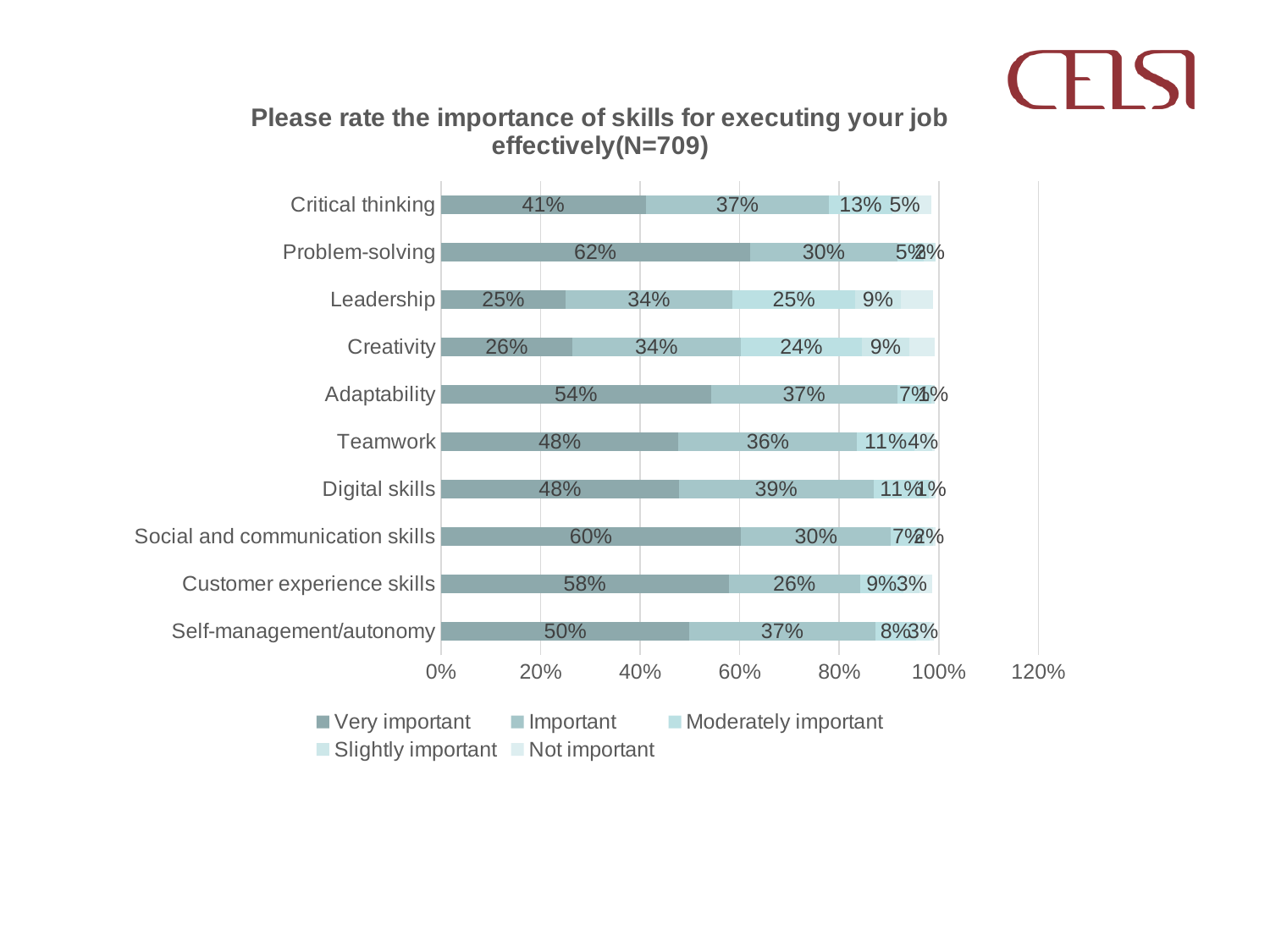
What kind of chart is shown on the slide? Stacked bar chart Which has a larger "Important" share: Teamwork or Digital skills? Digital skills What percentage of respondents rated Leadership as "Moderately important"? 25% What is the "Important" value for Customer experience skills? 26% Which skill has the highest "Very important" share? Problem-solving Which skill has the lowest "Very important" share? Leadership How many series does the legend list? 5 Is the "Very important" value for Adaptability greater or less than 40%? greater How many skills are listed on the chart? 10 What percentage of respondents rated Problem-solving as "Very important"? 62% For Critical thinking, what is the difference between the "Very important" and "Important" shares? 4 percentage points What is the sample size (N) stated in the chart title? 709